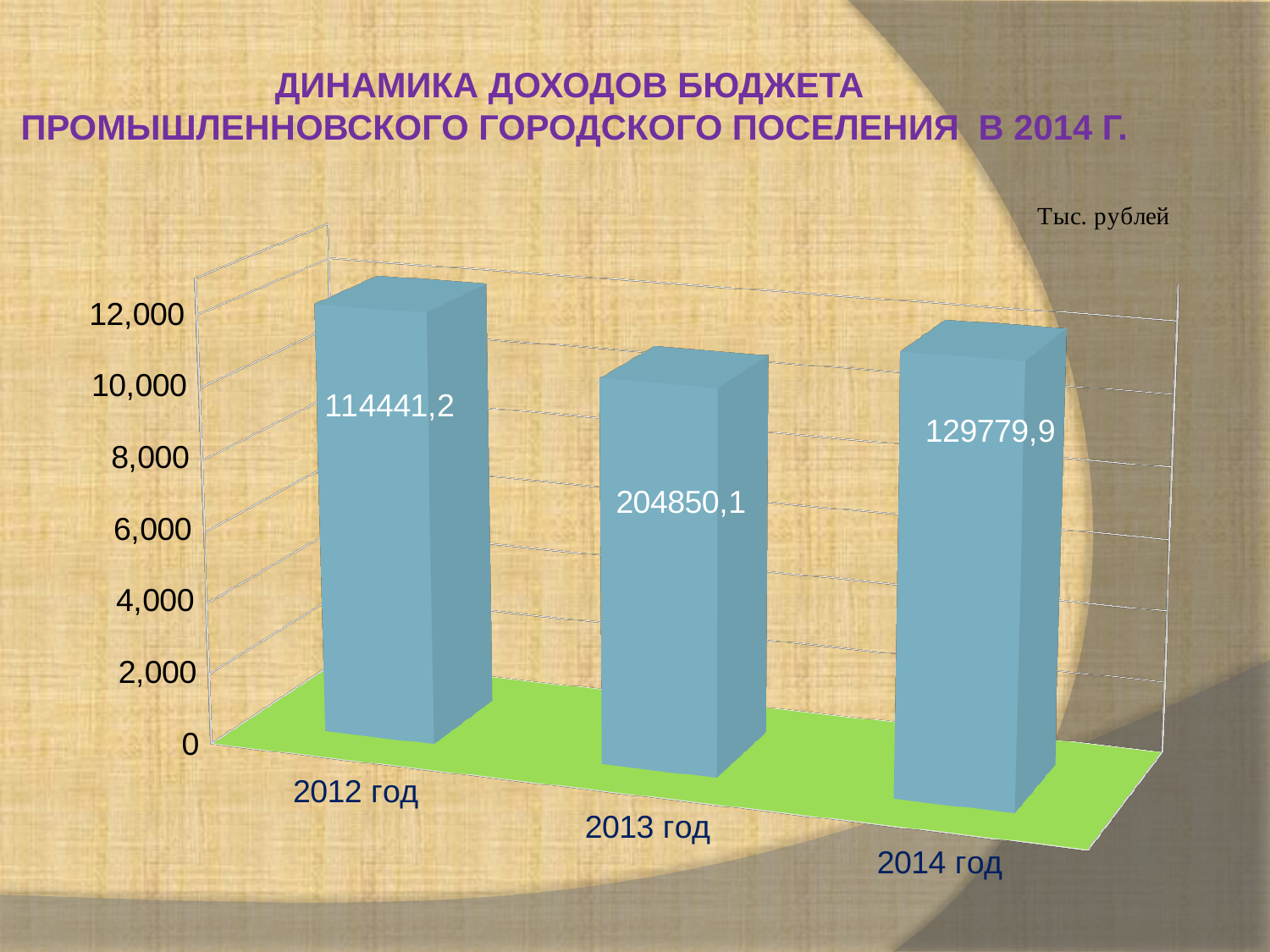
What kind of chart is shown on the slide? Bar chart How many years (categories) are shown on the chart? 3 What value is shown for 2014 год? 129779,9 What value is shown for 2013 год? 204850,1 What unit is indicated for the values on the chart? Тыс. рублей What is the title of the chart on the slide? ДИНАМИКА ДОХОДОВ БЮДЖЕТА ПРОМЫШЛЕННОВСКОГО ГОРОДСКОГО ПОСЕЛЕНИЯ В 2014 Г. What is the difference between the labelled values for 2013 год and 2012 год? 90408,9 What is the difference between the labelled values for 2014 год and 2012 год? 15338,7 What value is shown for 2012 год? 114441,2 What is the highest tick value shown on the vertical axis? 12,000